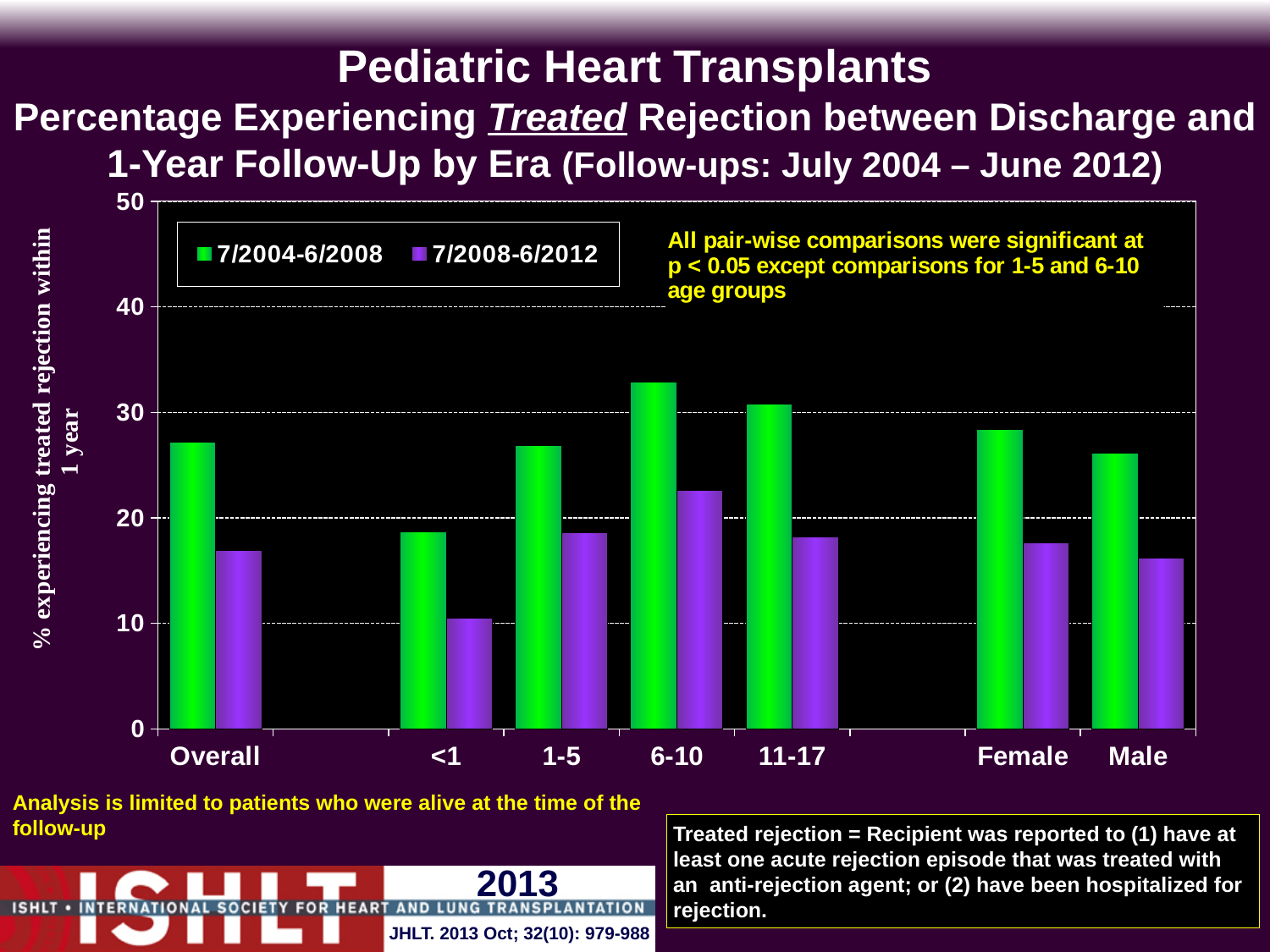
Is the 7/2004-6/2008 value for Overall greater or less than 20? greater Is the 7/2008-6/2012 value for <1 greater or less than 20? less Which category has the highest value for the 7/2008-6/2012 series? 6-10 Is the 7/2004-6/2008 value for 6-10 greater or less than 30? greater For the 6-10 age group, which era has the larger value, 7/2004-6/2008 or 7/2008-6/2012? 7/2004-6/2008 How many categories are shown along the x axis? 7 Which category has the lowest value for the 7/2004-6/2008 series? <1 How many series does the legend list? 2 Which category has the highest value for the 7/2004-6/2008 series? 6-10 Which category has the lowest value for the 7/2008-6/2012 series? <1 What kind of chart is shown on the slide? bar chart Which colour represents the 7/2008-6/2012 series? purple